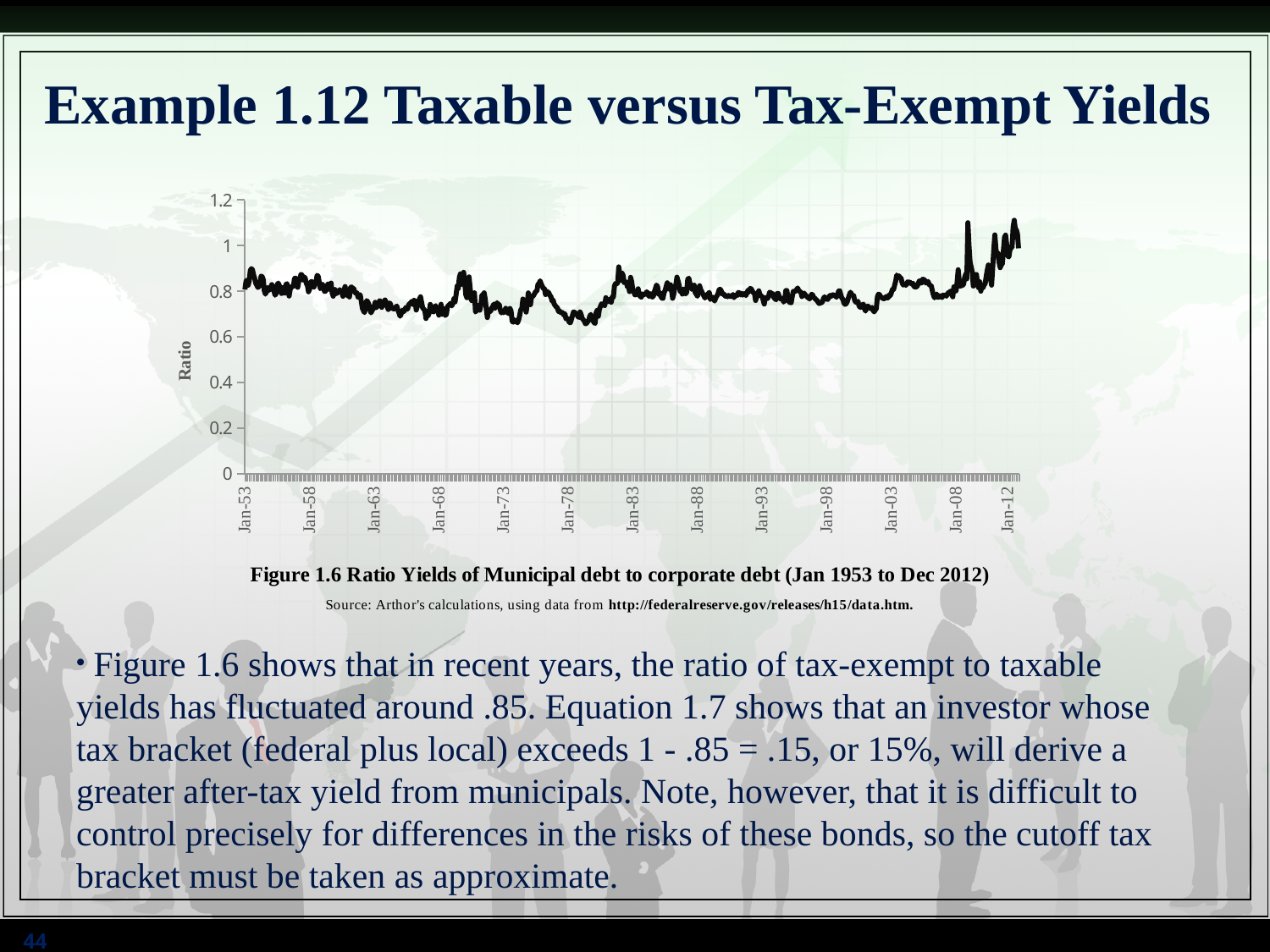
Is the ratio around Jan-78 greater or less than 0.8? less Is the ratio at Jan-53 greater or less than 0.6? greater What is the highest tick value shown on the y axis of the chart? 1.2 Is the ratio at Jan-03 greater or less than 0.6? greater Does the ratio rise or fall between Jan-03 and Jan-12? rise What is the title of the y axis of the chart? Ratio What kind of chart is shown on the slide? line chart